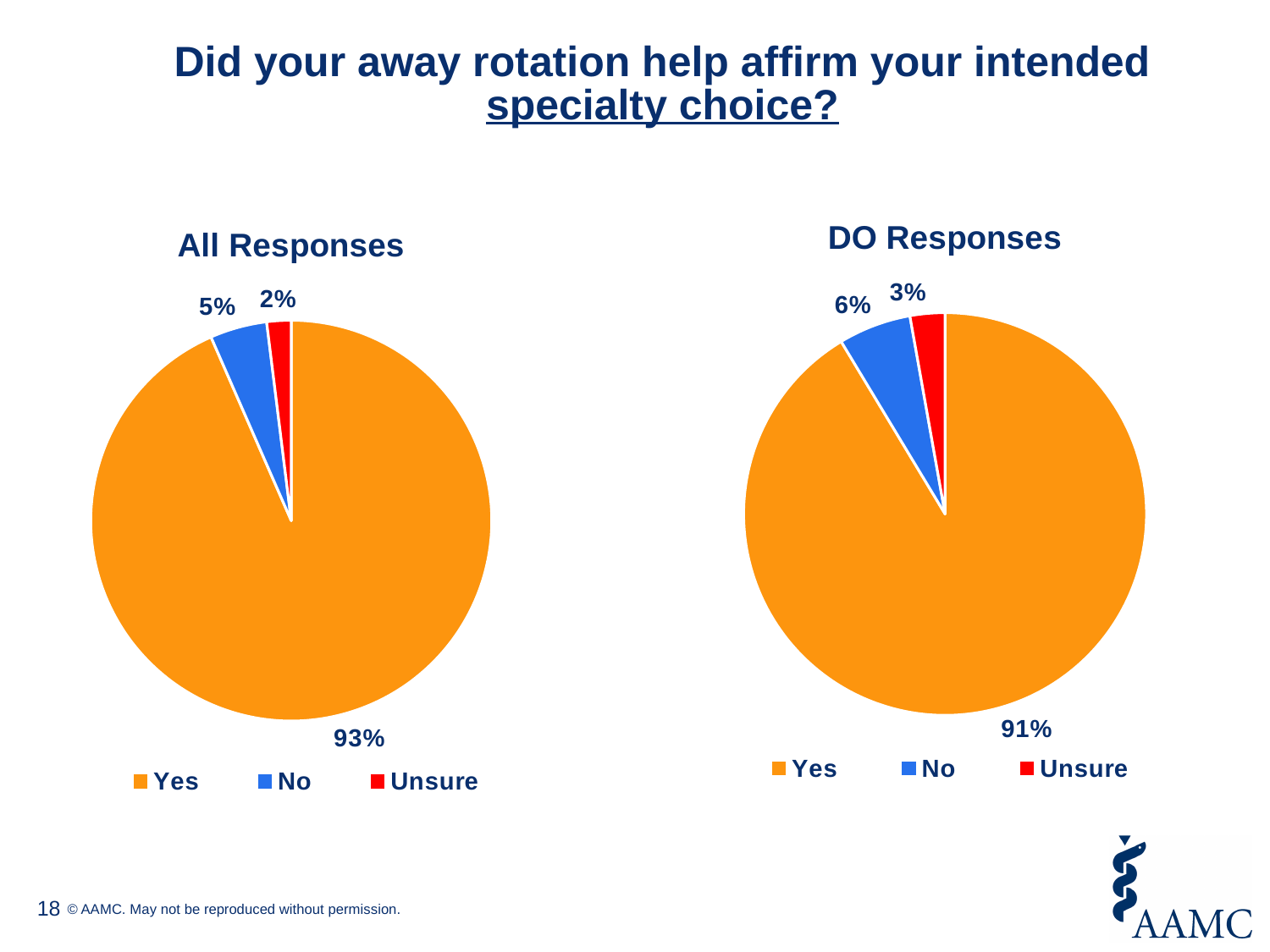
How many entries does the legend of the "DO Responses" chart list? 3 In the "DO Responses" chart, what percentage of respondents answered Yes? 91% How many slices does the "All Responses" pie chart have? 3 In the "DO Responses" chart, what percentage of respondents answered No? 6% In the "All Responses" chart, what colour represents the Unsure slice? Red What is the difference between the Yes share in the "All Responses" chart and the Yes share in the "DO Responses" chart? 2% In the "All Responses" chart, which response has the smallest share? Unsure What type of chart is used for "DO Responses"? Pie chart In the "All Responses" chart, what percentage of respondents answered Unsure? 2% Is the No share larger in the "All Responses" chart or the "DO Responses" chart? DO Responses In the "All Responses" chart, what percentage of respondents answered Yes? 93% In the "DO Responses" chart, which response has the largest share? Yes